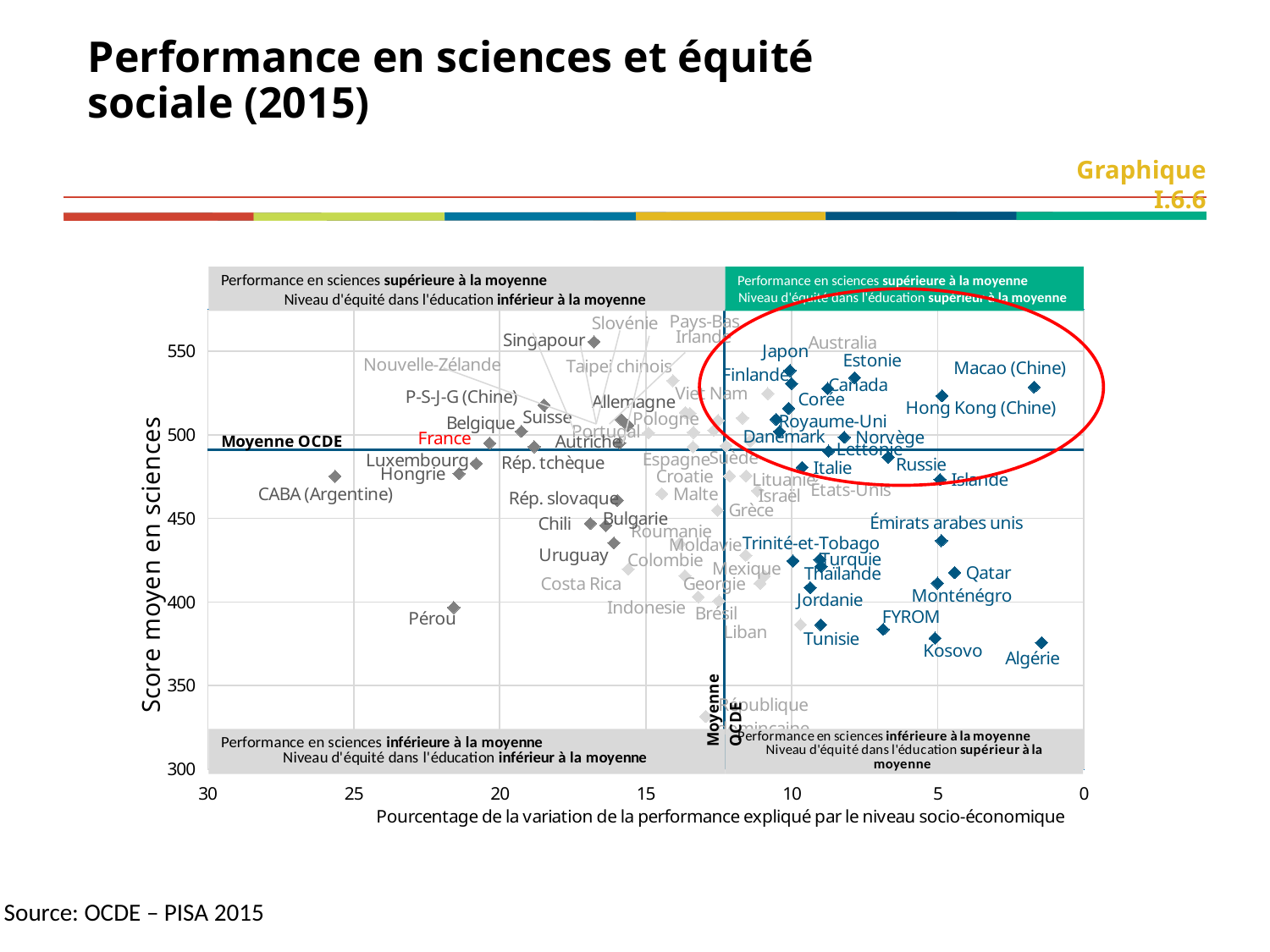
Is the science score for Pérou greater or less than 450? less Is the horizontal-axis value for CABA (Argentine) greater or less than 20? greater Is the horizontal-axis value for Macao (Chine) greater or less than 5? less What kind of chart is shown on the slide? scatter chart What is the label of the vertical axis of the chart? Score moyen en sciences What is the title of the chart on the slide? Performance en sciences et équité sociale (2015)